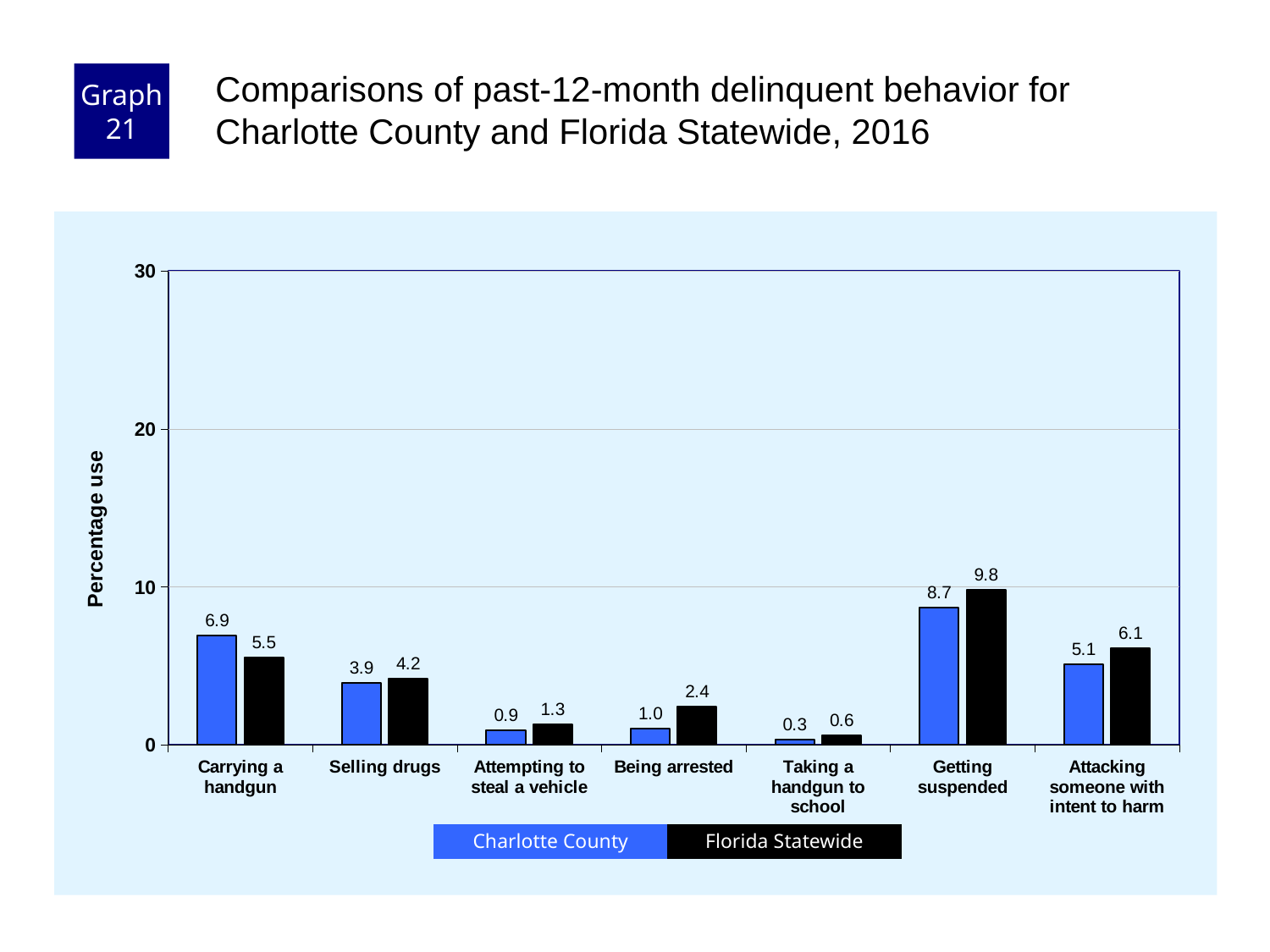
What kind of chart is shown on the slide? bar chart Is the Florida Statewide value for Getting suspended greater or less than 10? less What is the Charlotte County value for Taking a handgun to school? 0.3 What is the Charlotte County value for Getting suspended? 8.7 How many series does the legend list? 2 Which category has the lowest Charlotte County value? Taking a handgun to school How many categories are shown on the x axis? 7 What is the difference between the Florida Statewide and Charlotte County values for Carrying a handgun? 1.4 What is the Florida Statewide value for Being arrested? 2.4 What is the difference between the Florida Statewide and Charlotte County values for Getting suspended? 1.1 Which is larger for Attacking someone with intent to harm: Charlotte County or Florida Statewide? Florida Statewide Which category has the highest Florida Statewide value? Getting suspended